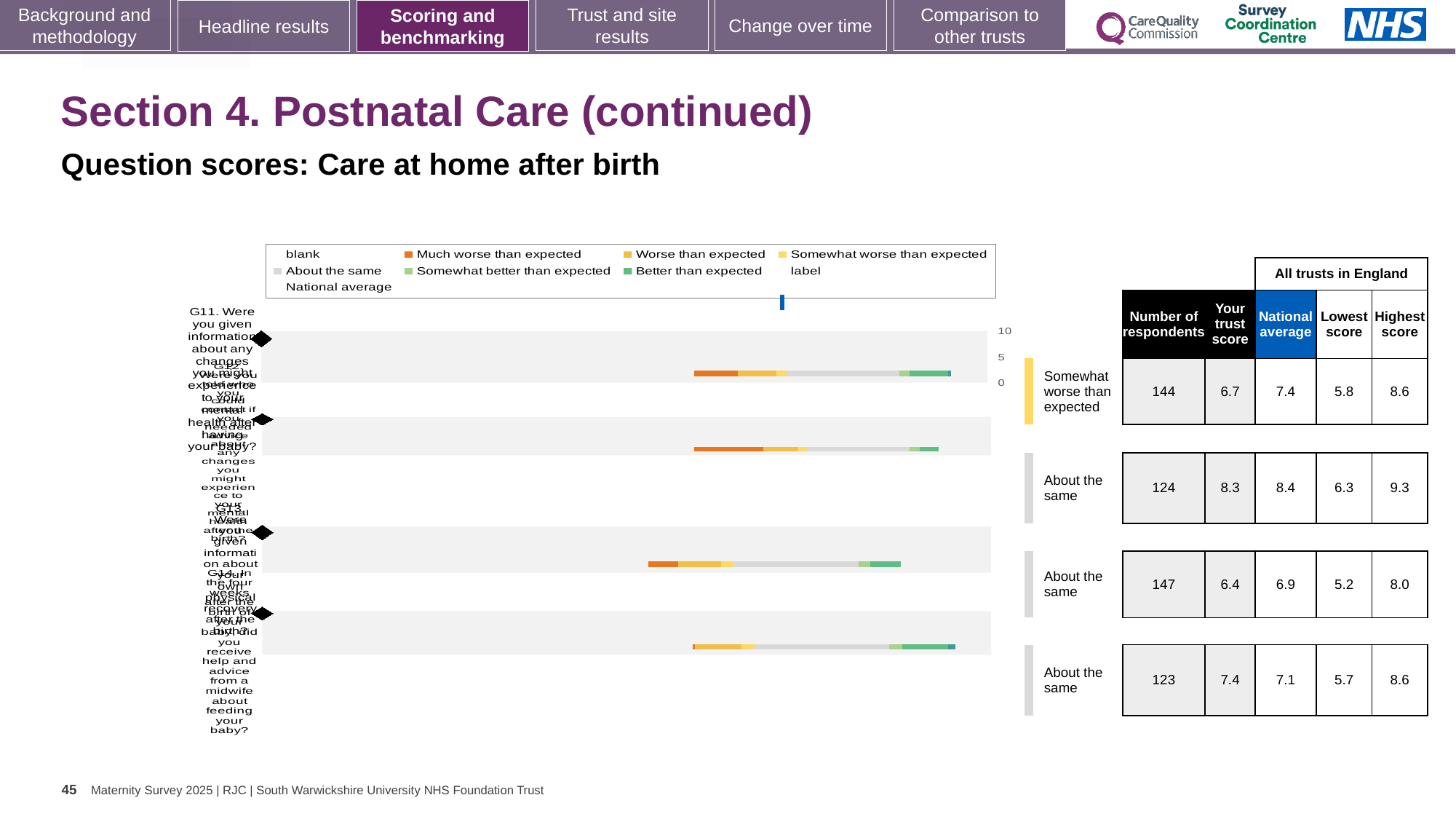
What is the highest score among all trusts in England for the first row (question G11)? 8.6 What kind of chart is shown on the slide? bar chart How many entries does the chart legend list? 9 What is the national average for the first row (question G11)? 7.4 What is the 'Your trust score' for the first row (question G11)? 6.7 How many respondents are recorded for the first row (question G11)? 144 How many question rows (bands) are plotted in the chart? 4 For the first row (question G11), which is larger: the trust score or the national average? national average What benchmark category is shown for the first row (question G11)? Somewhat worse than expected What is the lowest score among all trusts in England for the first row (question G11)? 5.8 What is the difference between the national average and the trust score for the first row (question G11)? 0.7